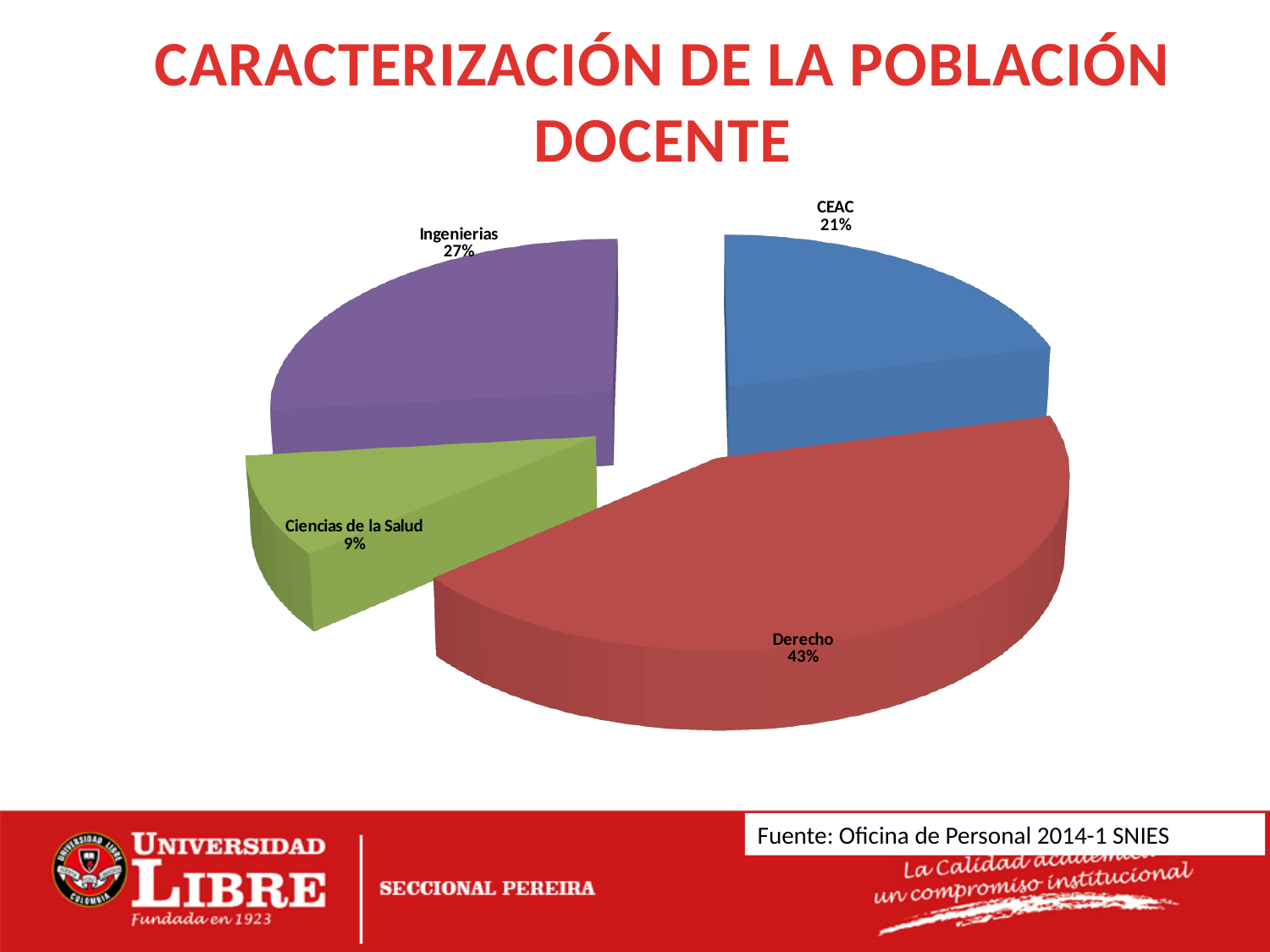
How many categories are shown in the pie chart? 4 What is the difference in percentage points between Ingenierias and Ciencias de la Salud? 18 Which is larger, the share for Ingenierias or the share for CEAC? Ingenierias Which category has the largest slice of the pie? Derecho What colour is the slice for Derecho? Red Which category has the smallest slice of the pie? Ciencias de la Salud What is the value shown for Ingenierias? 27% What is the difference in percentage points between Derecho and CEAC? 22 What share of the pie does Derecho represent? 43% What kind of chart is shown on the slide? Pie chart What is the value shown for CEAC? 21% What is the value shown for Ciencias de la Salud? 9%